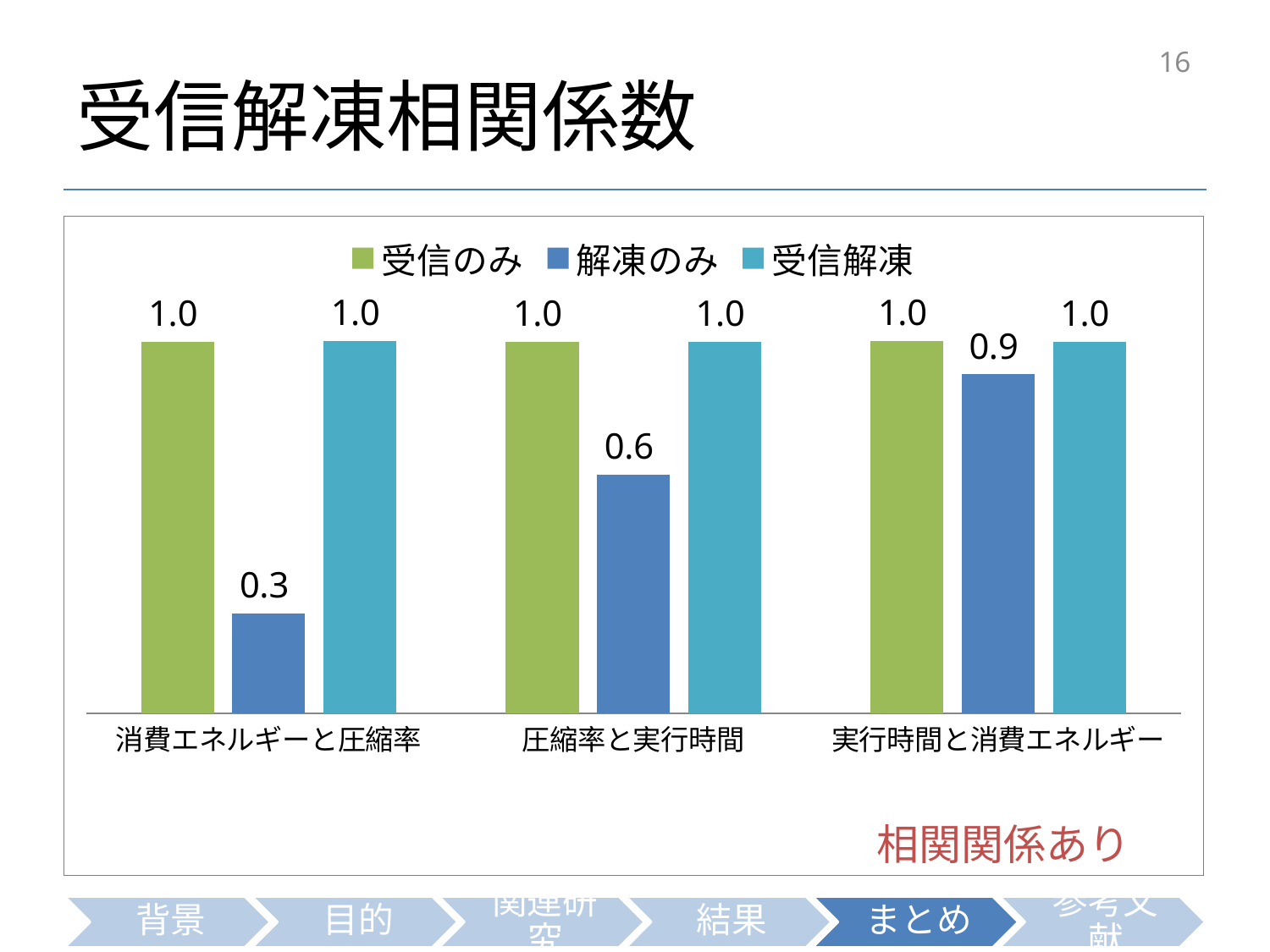
Which category has the highest value for the 解凍のみ series? 実行時間と消費エネルギー Which is larger for 圧縮率と実行時間: the 解凍のみ value or the 受信解凍 value? 受信解凍 How many categories are shown on the x axis? 3 What is the value of 受信のみ for 圧縮率と実行時間? 1.0 What is the value of 解凍のみ for 消費エネルギーと圧縮率? 0.3 Do the 解凍のみ values rise or fall from left to right across the categories? Rise What kind of chart is shown on the slide? Bar chart What is the value of 解凍のみ for 圧縮率と実行時間? 0.6 What is the value of 解凍のみ for 実行時間と消費エネルギー? 0.9 How many series does the legend list? 3 What is the difference between the 受信のみ and 解凍のみ values for 消費エネルギーと圧縮率? 0.7 Which category has the lowest value for the 解凍のみ series? 消費エネルギーと圧縮率